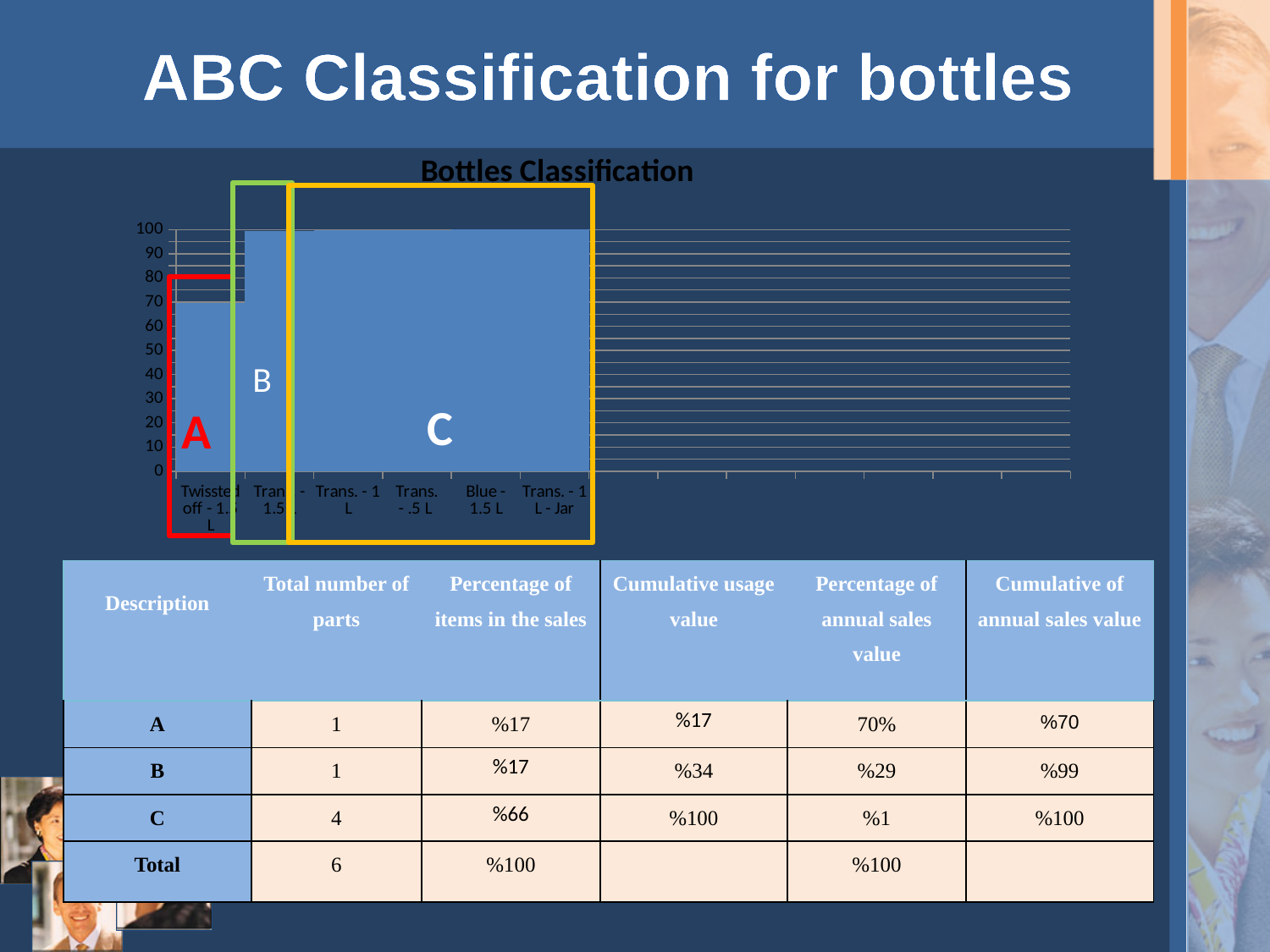
In the Bottles Classification chart, is the value for Trans. - 1 L - Jar greater or less than 90? greater In the Bottles Classification chart, which is larger: the bar for Twissted off - 1.5 L or the bar for Trans. - 1 L - Jar? Trans. - 1 L - Jar What is the highest tick value shown on the y axis of the Bottles Classification chart? 100 What kind of chart is shown on the slide? bar chart Which category has the lowest bar in the Bottles Classification chart? Twissted off - 1.5 L What is the title of the chart on the slide? Bottles Classification In the Bottles Classification chart, is the value for Blue - 1.5 L greater or less than 80? greater In the Bottles Classification chart, is the value for the first bar (Twissted off - 1.5 L) greater or less than 80? less Do the bar values in the Bottles Classification chart rise or fall from left to right along the x axis? rise How many categories are plotted along the x axis of the Bottles Classification chart? 6 What is the label of the last category on the x axis of the Bottles Classification chart? Trans. - 1 L - Jar